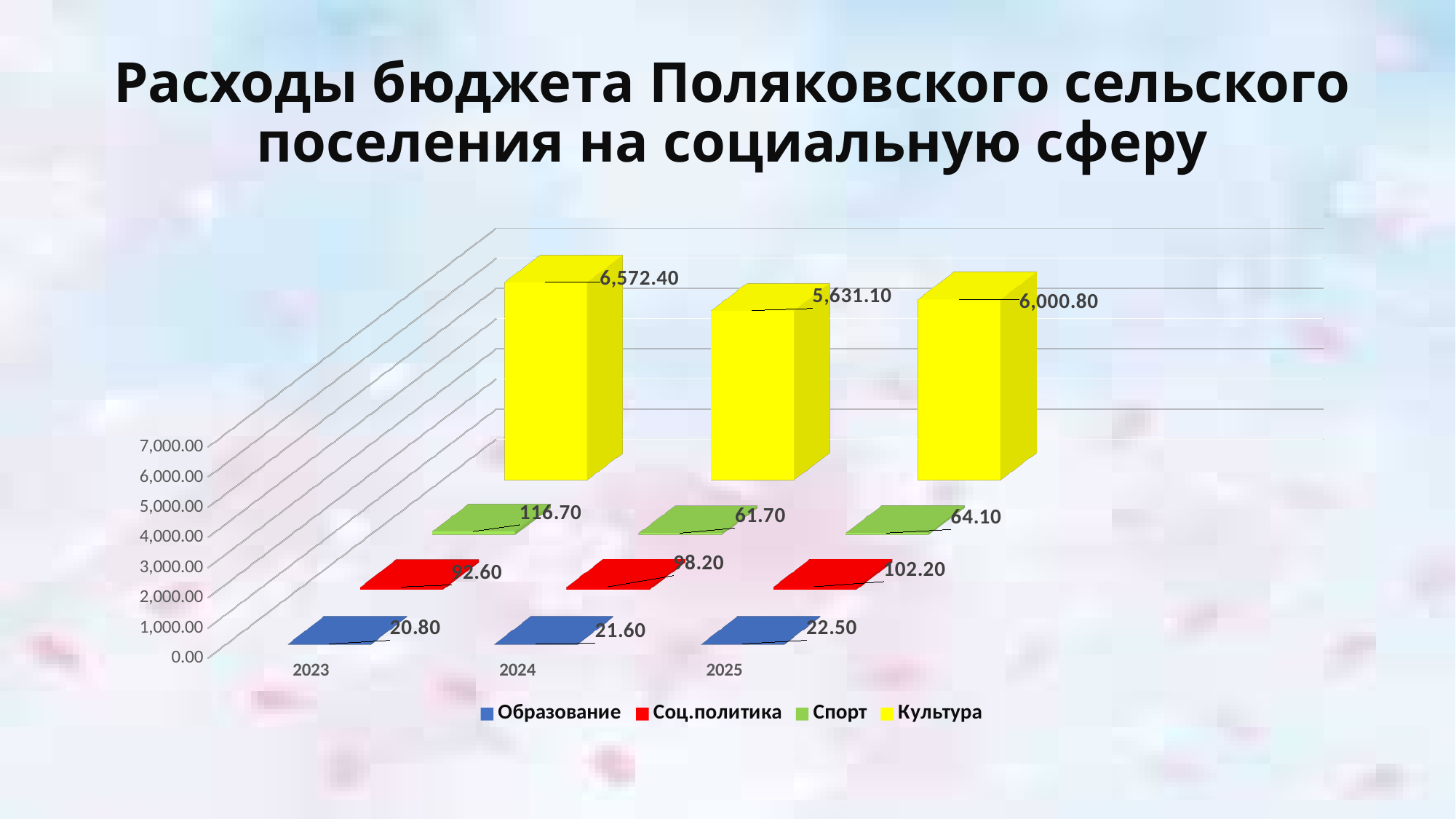
What is the value for Культура in 2023? 6,572.40 What is the difference between the Культура values for 2023 and 2024? 941.30 What is the value for Спорт in 2024? 61.70 In which year is the value for Спорт the lowest? 2024 What is the value for Образование in 2025? 22.50 How many series does the legend list? 4 In which year is the value for Культура the highest? 2023 What kind of chart is shown on the slide? Bar chart How many years are shown on the x axis? 3 What is the value for Соц.политика in 2024? 98.20 Do the values for Образование rise or fall from 2023 to 2025? Rise Which is larger: the Соц.политика value for 2025 or the Спорт value for 2025? Соц.политика (102.20)